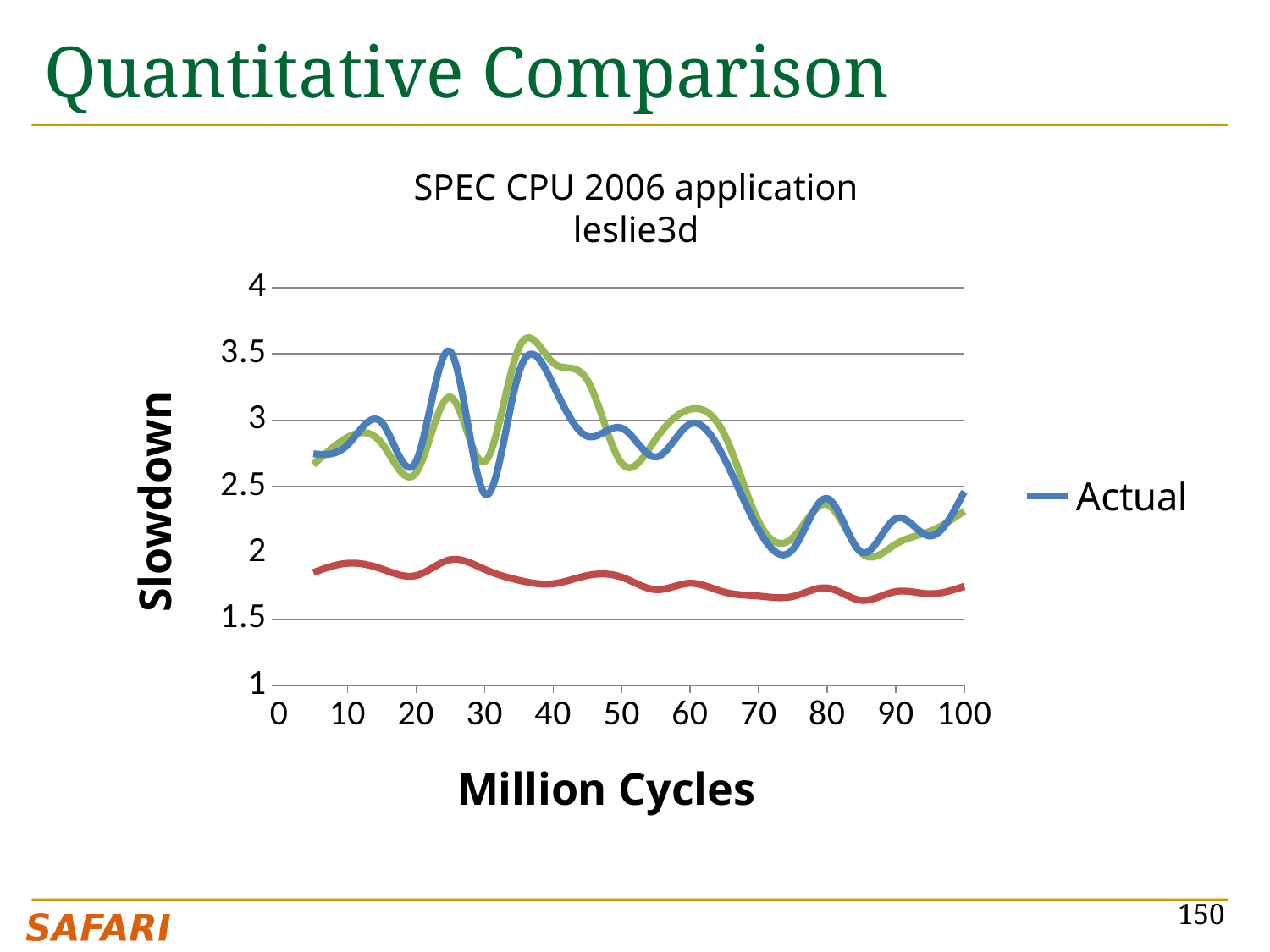
At 50 million cycles, which is larger: the Actual series or the red line? Actual How many lines are plotted on the chart? 3 What is the label of the y axis? Slowdown Is the value of the red line at 50 million cycles greater or less than 2? less Is the value of the Actual series at 75 million cycles greater or less than 2.5? less How many series does the chart legend list? 1 Is the value of the Actual series at 25 million cycles greater or less than 3? greater Does the Actual series overall rise or fall between 0 and 100 million cycles? fall What kind of chart is shown on the slide? line chart What is the title of the chart? SPEC CPU 2006 application leslie3d